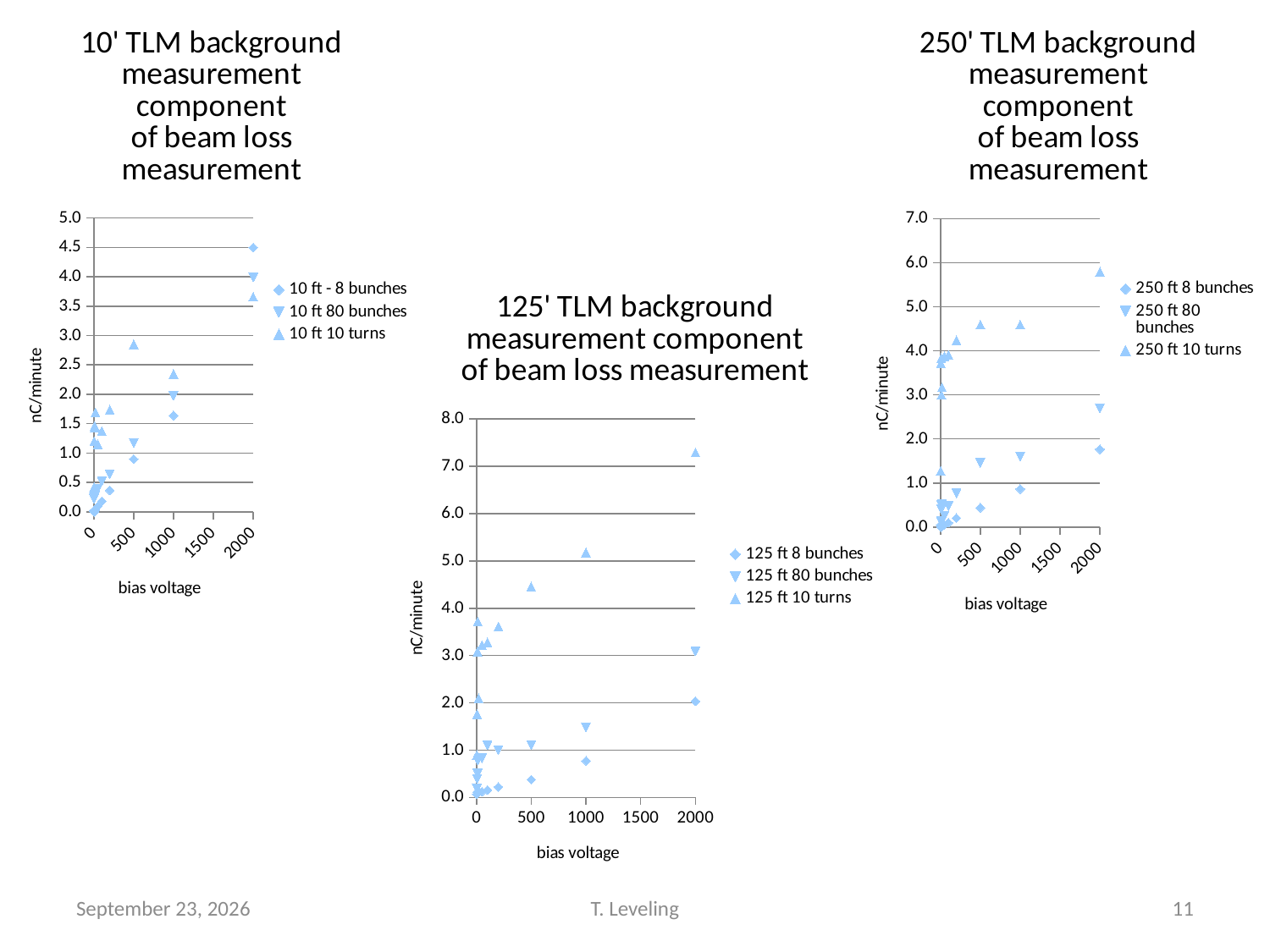
What kind of chart is the '10' TLM background measurement component of beam loss measurement' chart? scatter chart In the '250' TLM background measurement component of beam loss measurement' chart, is the value for '250 ft 10 turns' at a bias voltage of 2000 greater or less than 5.0? greater In the '250' TLM background measurement component of beam loss measurement' chart, is the value for '250 ft 8 bunches' at a bias voltage of 2000 greater or less than 2.0? less In the '125' TLM background measurement component of beam loss measurement' chart, is the value for '125 ft 10 turns' at a bias voltage of 2000 greater or less than 7.0? greater In the '10' TLM background measurement component of beam loss measurement' chart, do the values for '10 ft - 8 bunches' rise or fall as bias voltage increases? rise What is the y-axis title of the '10' TLM background measurement component of beam loss measurement' chart? nC/minute In the '250' TLM background measurement component of beam loss measurement' chart, what are the three legend entries? 250 ft 8 bunches, 250 ft 80 bunches, 250 ft 10 turns How many series does the legend of the '125' TLM background measurement component of beam loss measurement' chart list? 3 In the '250' TLM background measurement component of beam loss measurement' chart, which series has the highest value at a bias voltage of 2000? 250 ft 10 turns In the '125' TLM background measurement component of beam loss measurement' chart, at a bias voltage of 2000, which series has the larger value: '125 ft 10 turns' or '125 ft 8 bunches'? 125 ft 10 turns